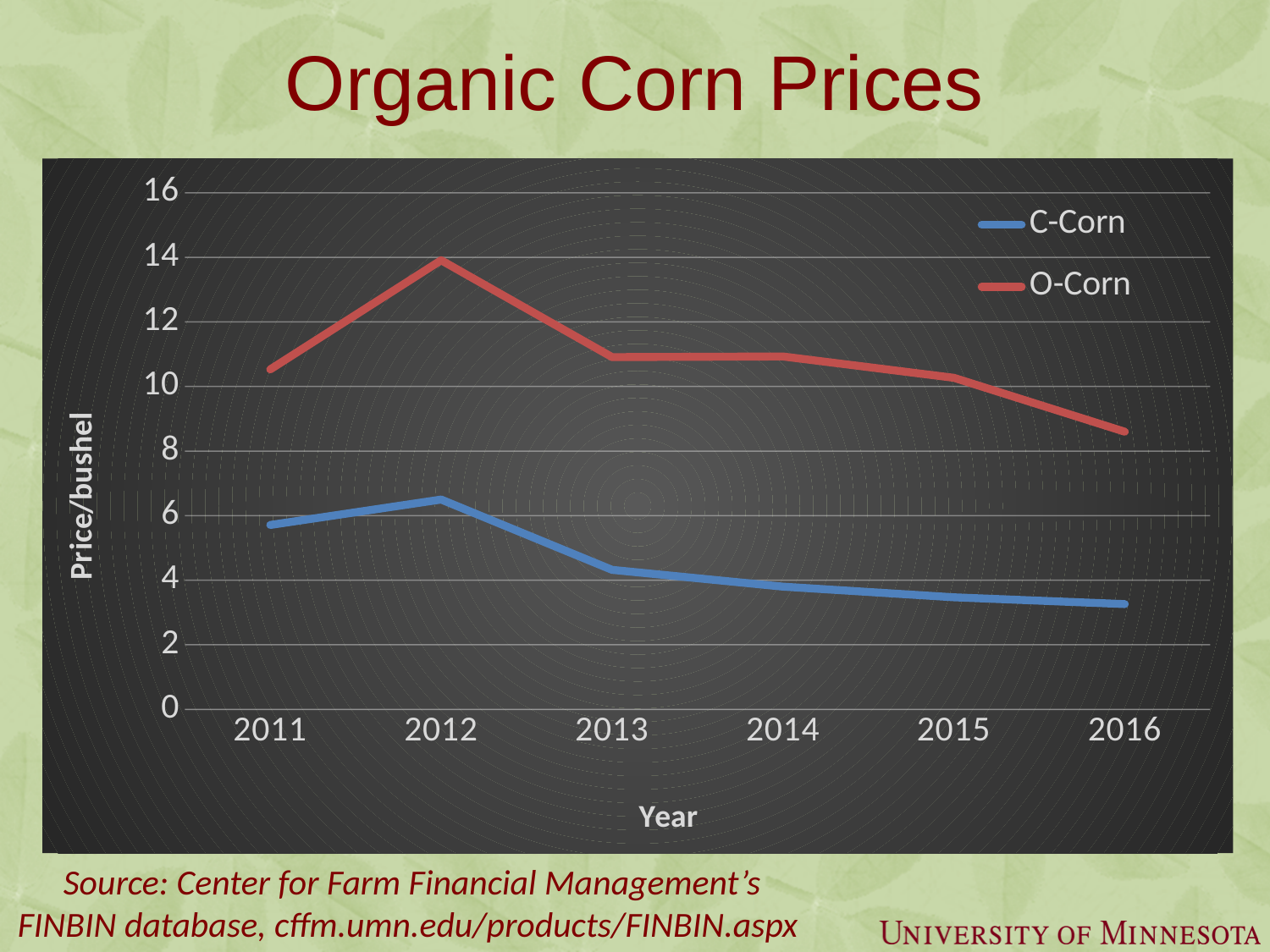
Is the O-Corn value for 2012 greater or less than 12? greater In which year is the O-Corn price lowest? 2016 What kind of chart is shown on the slide? Line chart Is the C-Corn value for 2016 greater or less than 4? less How many years are plotted along the x axis? 6 Which series has the higher value in 2014, C-Corn or O-Corn? O-Corn What is the label on the vertical axis? Price/bushel In which year is the C-Corn price highest? 2012 In which year is the O-Corn price highest? 2012 Is the O-Corn value for 2016 greater or less than 10? less In which year is the C-Corn price lowest? 2016 How many series does the legend list? 2